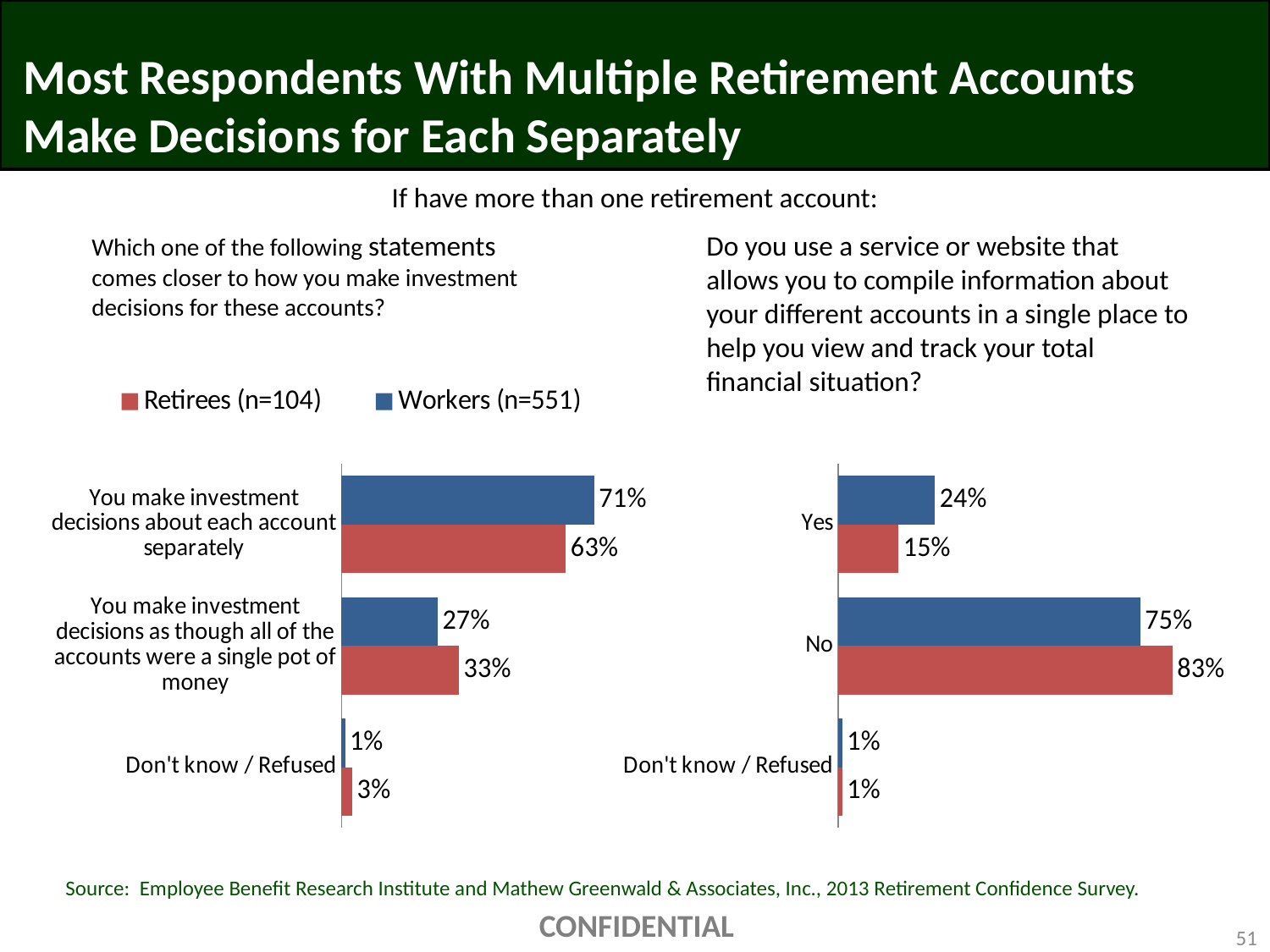
How many response categories are shown in the left chart on investment decisions? 3 In the right chart on using a service or website, what percentage of Retirees answered Yes? 15% In the right chart on using a service or website, which group has the higher Yes value, Retirees or Workers? Workers In the right chart on using a service or website, which response category has the highest value for Retirees? No How many series does the legend list? 2 In the left chart on investment decisions, what is the difference between the Workers and Retirees values for making decisions about each account separately? 8 percentage points In the right chart on using a service or website, what is the difference between the Retirees and Workers values for No? 8 percentage points In the left chart on investment decisions, what percentage of Workers make investment decisions about each account separately? 71% What type of chart is used on this slide? Bar chart In the left chart on investment decisions, what percentage of Retirees make investment decisions as though all of the accounts were a single pot of money? 33% In the left chart on investment decisions, which group has the higher value for treating all accounts as a single pot of money, Retirees or Workers? Retirees In the right chart on using a service or website, what percentage of Workers answered No? 75%